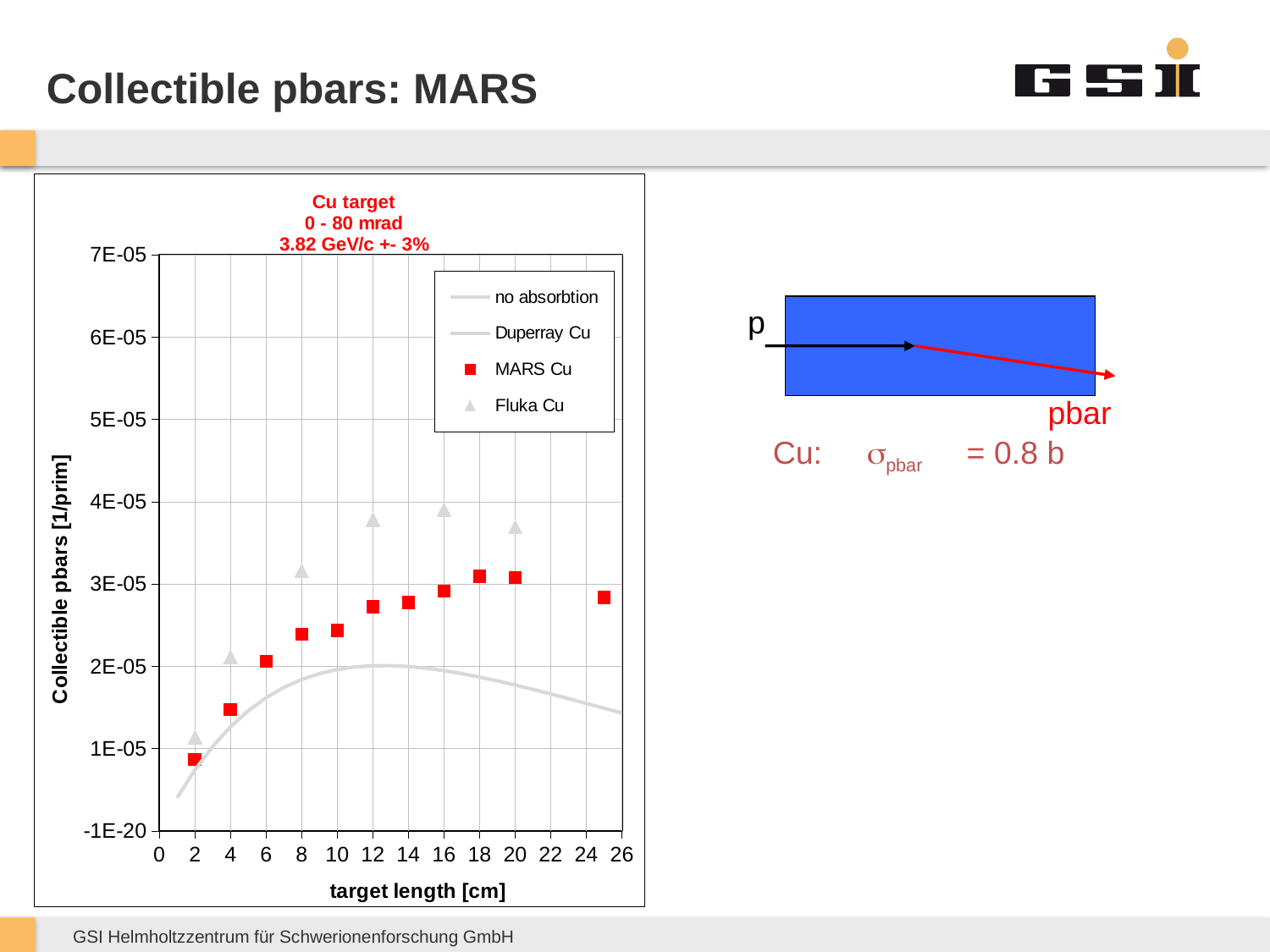
Do the MARS Cu values rise or fall as target length increases from 2 cm to 20 cm? rise At which target length is the MARS Cu value lowest? 2 cm What is the label of the x axis of the chart? target length [cm] Is the Fluka Cu value at a target length of 16 cm greater or less than 3E-05? greater Is the MARS Cu value at a target length of 12 cm greater or less than 2E-05? greater Is the MARS Cu value at a target length of 2 cm greater or less than 1E-05? less At a target length of 12 cm, which series has the larger value, MARS Cu or Fluka Cu? Fluka Cu How many MARS Cu data points are plotted on the chart? 11 How many series does the chart legend list? 4 How many Fluka Cu data points are plotted on the chart? 6 What kind of chart is shown on the slide? scatter chart